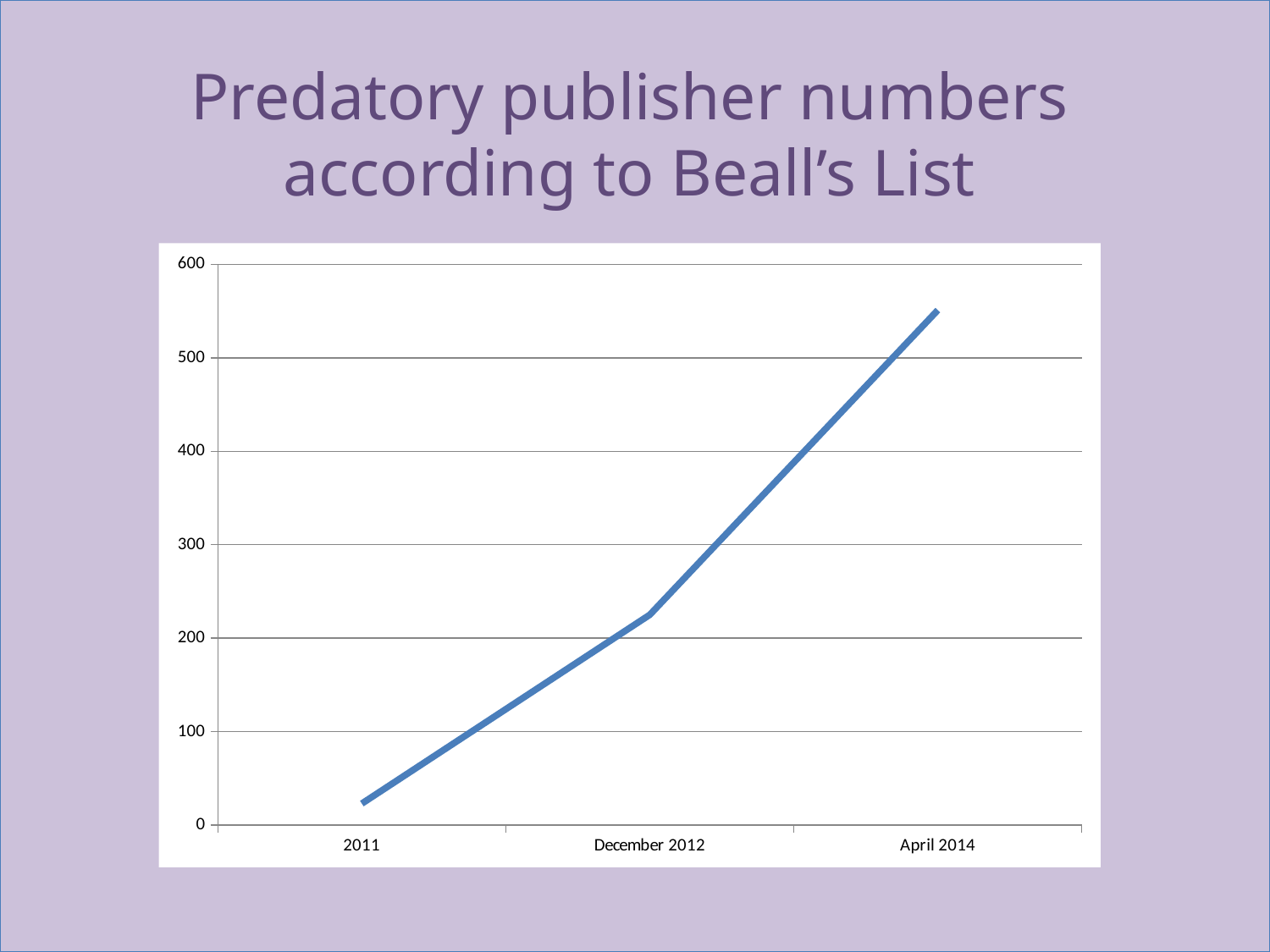
Which is larger, the value for December 2012 or the value for 2011? December 2012 Is the value for December 2012 greater or less than 300? less What is the highest value shown on the y axis? 600 What kind of chart is shown on the slide? line chart What is the title of the slide containing the chart? Predatory publisher numbers according to Beall's List Which point on the x axis has the lowest value? 2011 Do the values rise or fall from 2011 to April 2014? rise Is the value for 2011 greater or less than 100? less Which point on the x axis has the highest value? April 2014 Is the value for April 2014 greater or less than 500? greater How many data points are plotted on the line? 3